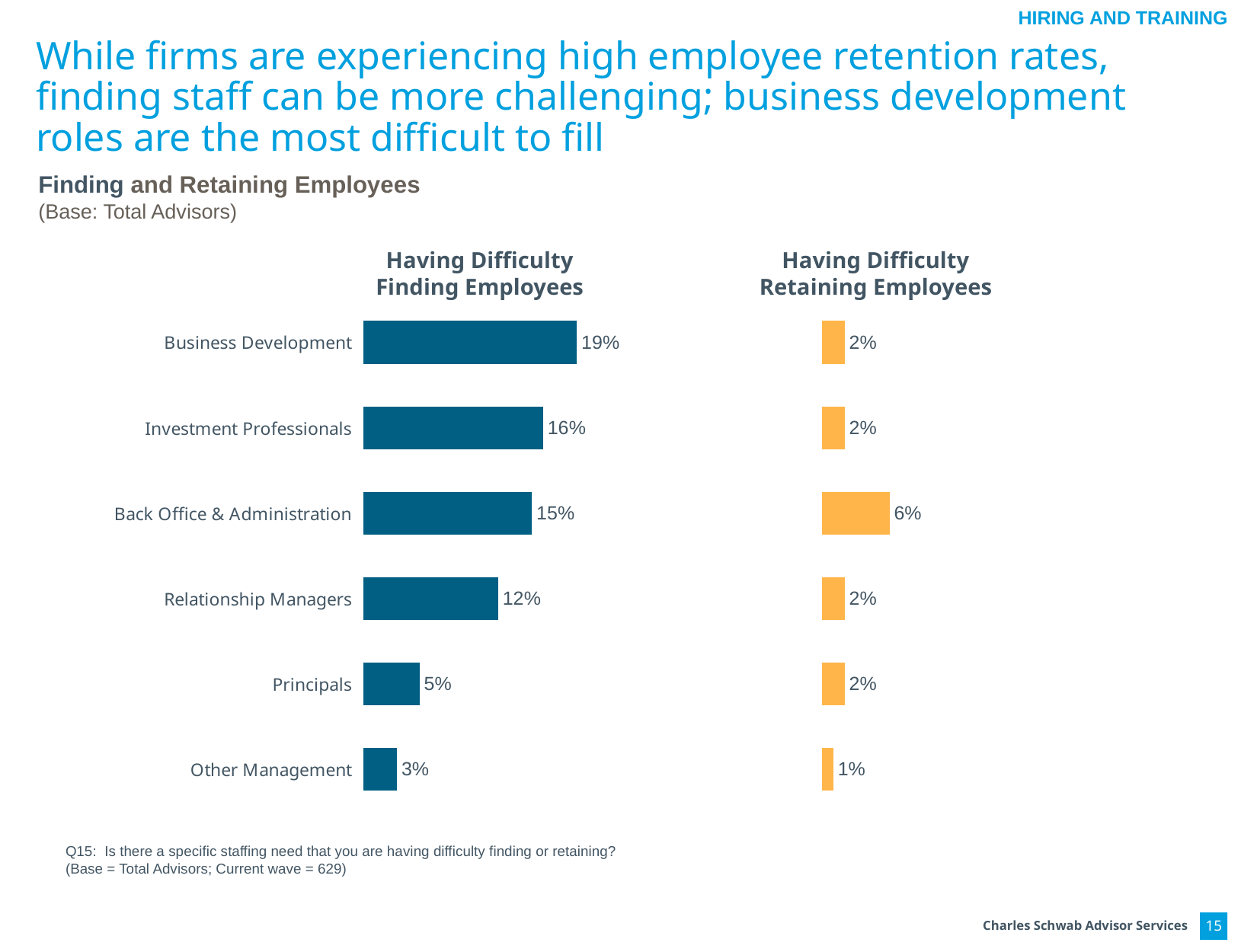
In the 'Having Difficulty Finding Employees' chart, what is the value for Principals? 5% In the 'Having Difficulty Retaining Employees' chart, what is the value for Back Office & Administration? 6% In the 'Having Difficulty Finding Employees' chart, what is the value for Business Development? 19% In the 'Having Difficulty Retaining Employees' chart, which category has the highest value? Back Office & Administration In the 'Having Difficulty Retaining Employees' chart, what is the value for Other Management? 1% What kind of chart is the 'Having Difficulty Retaining Employees' chart? Bar chart In the 'Having Difficulty Finding Employees' chart, which category has the lowest value? Other Management What colour are the bars in the 'Having Difficulty Retaining Employees' chart? Orange How many categories are shown in the 'Having Difficulty Finding Employees' chart? 6 In the 'Having Difficulty Finding Employees' chart, what is the difference between Business Development and Investment Professionals? 3% In the 'Having Difficulty Finding Employees' chart, which is larger: Relationship Managers or Back Office & Administration? Back Office & Administration In the 'Having Difficulty Finding Employees' chart, which category has the highest value? Business Development